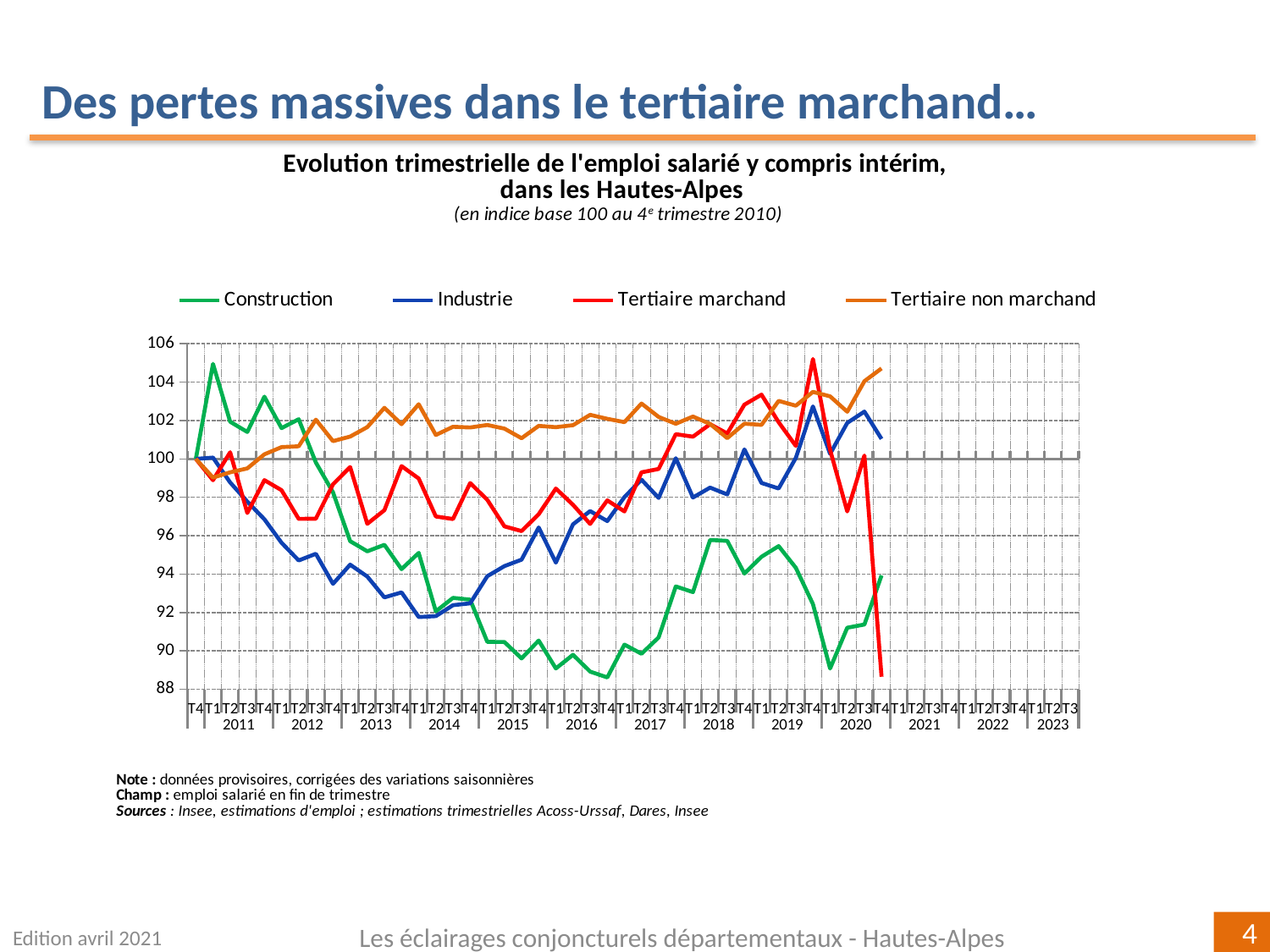
Is the value for Construction at T1 2011 greater or less than 104? greater What is the base period of the index used in the chart? 4e trimestre 2010 Is the value for Industrie at T4 2019 greater or less than 102? greater Which series is drawn in red? Tertiaire marchand Is the value for Tertiaire non marchand at T4 2020 greater or less than 104? greater How many series does the legend list? 4 Which series has the lowest value at the last plotted point (T4 2020)? Tertiaire marchand Which series has the highest value at the last plotted point (T4 2020)? Tertiaire non marchand Does the Construction series rise or fall between T1 2011 and T3 2016? fall What kind of chart is shown on the slide? line chart At T4 2020, which is larger: Industrie or Construction? Industrie